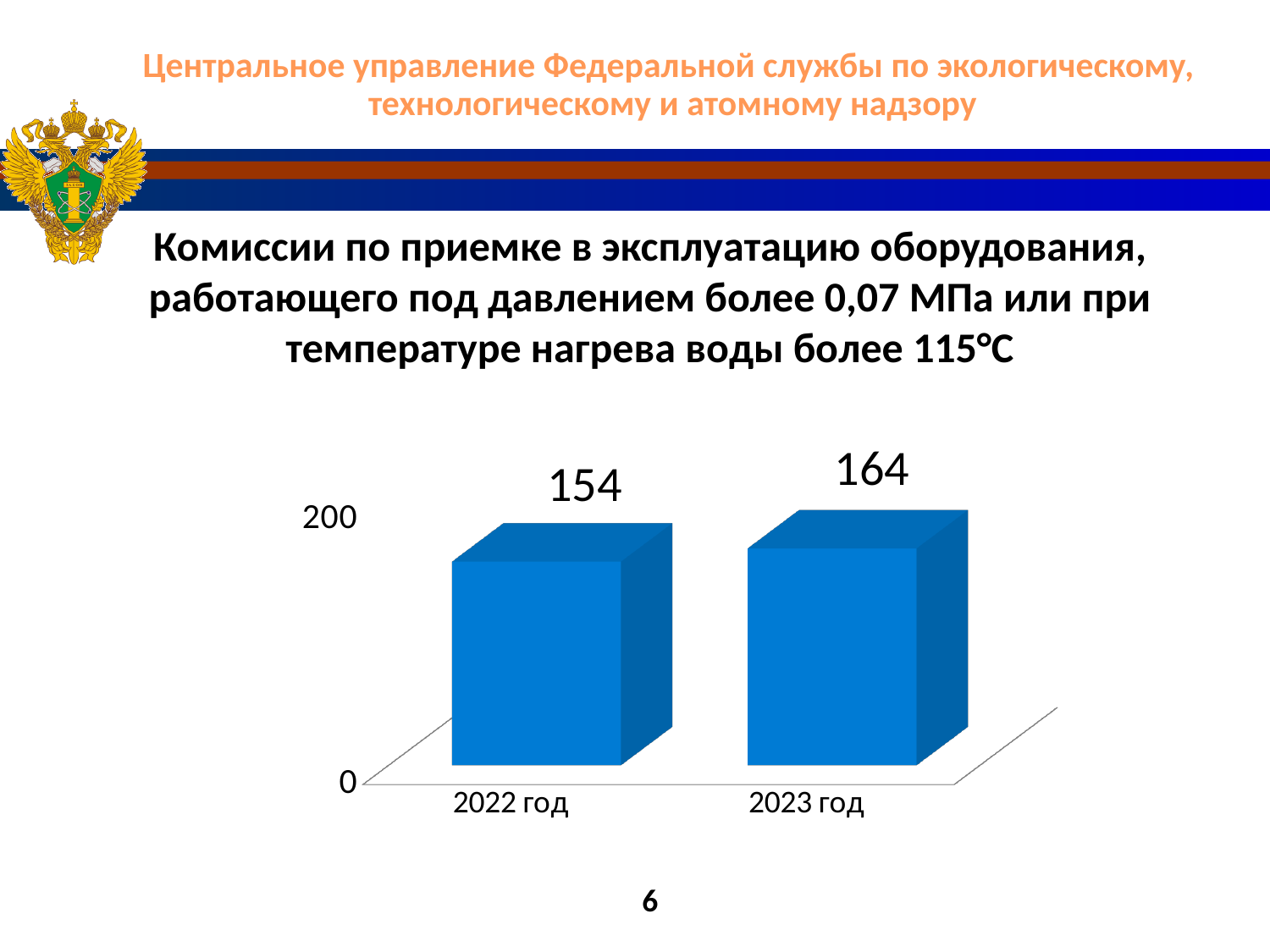
What colour are the bars in the chart? blue What kind of chart is shown on the slide? bar chart Do the values rise or fall from 2022 год to 2023 год? rise Which year has the lowest value? 2022 год Is the value for 2023 год greater or less than 200? less What is the value for 2022 год? 154 What is the highest tick value shown on the vertical axis? 200 What is the difference between the values for 2023 год and 2022 год? 10 Which is larger, the value for 2022 год or the value for 2023 год? 2023 год Which year has the highest value? 2023 год What is the value for 2023 год? 164 How many categories are shown on the x axis? 2